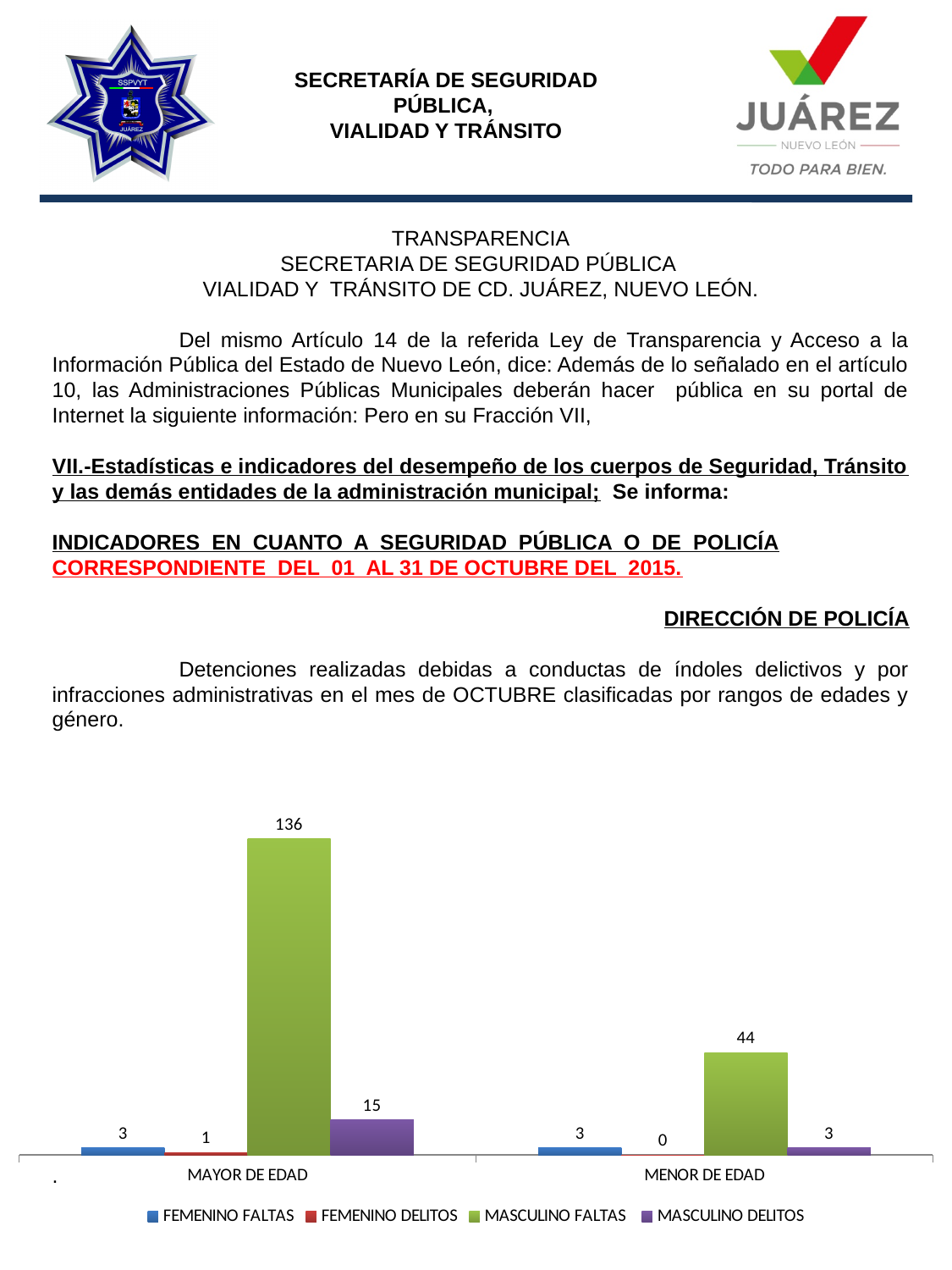
How many categories are shown on the x axis of the chart? 2 What is the total of all four series for the MENOR DE EDAD category? 50 Which series has the highest value in the MAYOR DE EDAD category? MASCULINO FALTAS What is the value for MASCULINO FALTAS in the MAYOR DE EDAD category? 136 What kind of chart is shown on the slide? Bar chart Which series has the lowest value in the MENOR DE EDAD category? FEMENINO DELITOS What is the value for MASCULINO DELITOS in the MAYOR DE EDAD category? 15 How many series does the chart legend list? 4 What is the value for FEMENINO DELITOS in the MENOR DE EDAD category? 0 What is the value for MASCULINO DELITOS in the MENOR DE EDAD category? 3 What is the difference between MASCULINO FALTAS for MAYOR DE EDAD and MASCULINO FALTAS for MENOR DE EDAD? 92 Which is larger: MASCULINO DELITOS for MAYOR DE EDAD or MASCULINO FALTAS for MENOR DE EDAD? MASCULINO FALTAS for MENOR DE EDAD